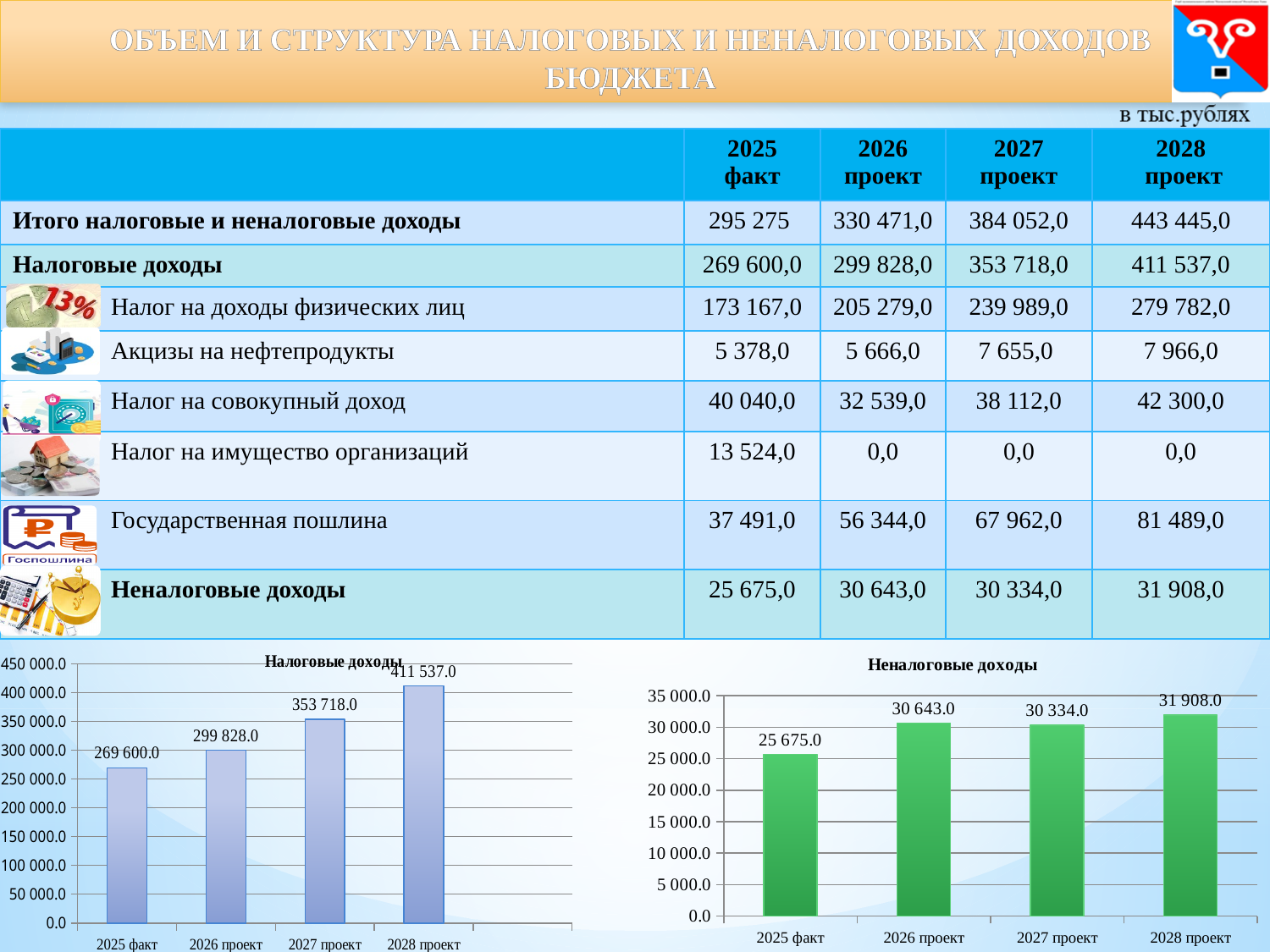
In the 'Налоговые доходы' chart, what is the value for 2027 проект? 353 718.0 What colour are the bars in the 'Неналоговые доходы' chart? green In the 'Неналоговые доходы' chart, what is the difference between the values for 2026 проект and 2027 проект? 309.0 In the 'Налоговые доходы' chart, do the values rise or fall from 2025 факт to 2028 проект? rise How many bars are shown in the 'Неналоговые доходы' chart? 4 In the 'Неналоговые доходы' chart, which category has the lowest value? 2025 факт In the 'Налоговые доходы' chart, is the value for 2026 проект greater or less than 300 000.0? less What type of chart is the 'Налоговые доходы' chart? bar chart In the 'Налоговые доходы' chart, which category has the highest value? 2028 проект In the 'Неналоговые доходы' chart, what is the value for 2025 факт? 25 675.0 In the 'Неналоговые доходы' chart, which is larger: the value for 2026 проект or 2027 проект? 2026 проект In the 'Налоговые доходы' chart, what is the difference between the values for 2028 проект and 2025 факт? 141 937.0